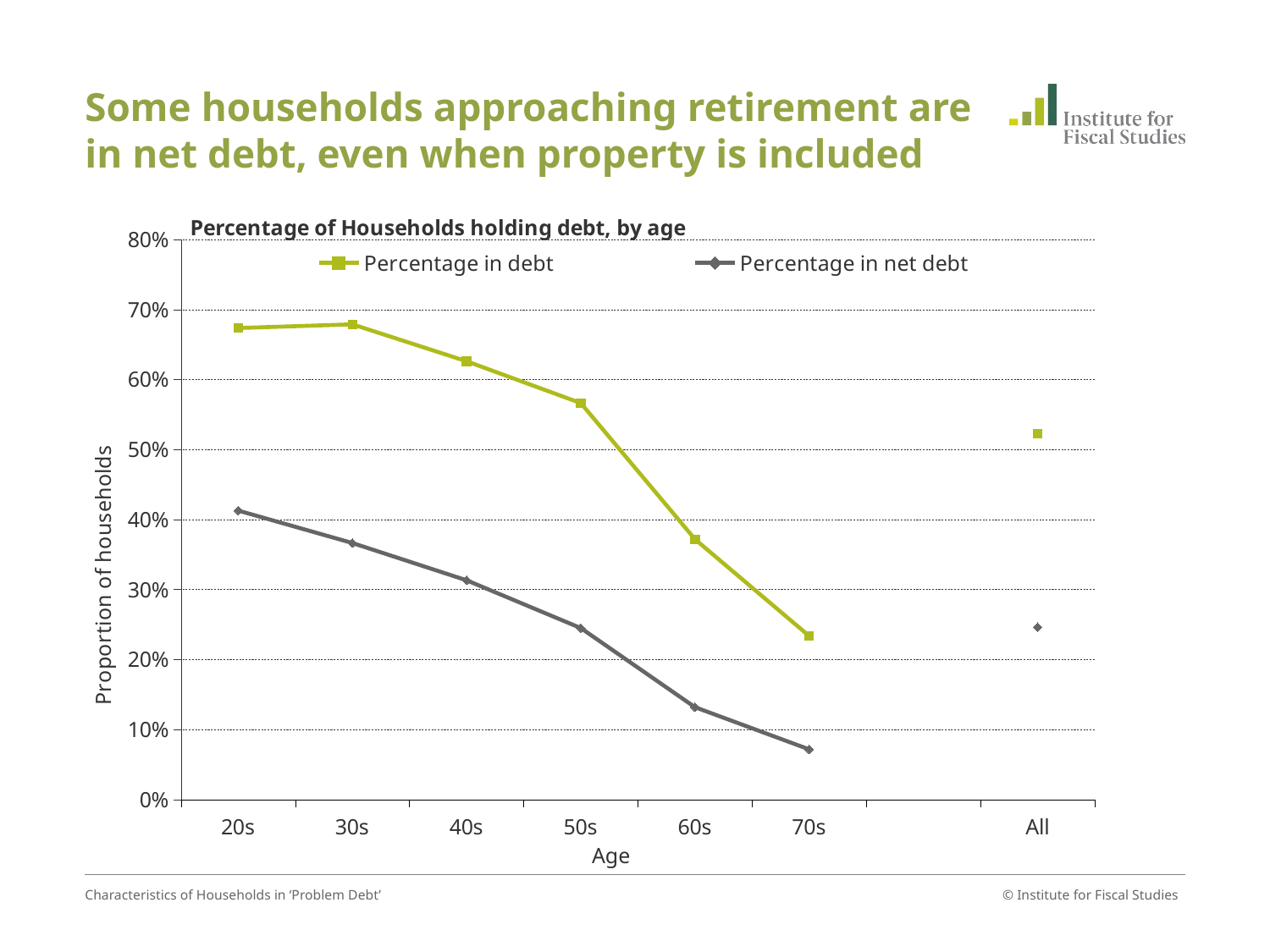
Which age group has the lowest value for Percentage in debt? 70s Is the value for Percentage in net debt for the 20s greater or less than 30%? greater How many series does the legend list? 2 Which age group has the highest value for Percentage in net debt? 20s What type of chart is shown on the slide? Line chart Which is larger for the 60s: Percentage in debt or Percentage in net debt? Percentage in debt How many categories are labelled on the x axis? 7 Is the value for Percentage in debt for the 40s greater or less than 60%? greater Is the value for Percentage in debt for the 60s greater or less than 40%? less Which age group has the lowest value for Percentage in net debt? 70s Does Percentage in net debt rise or fall from the 20s to the 70s? Fall